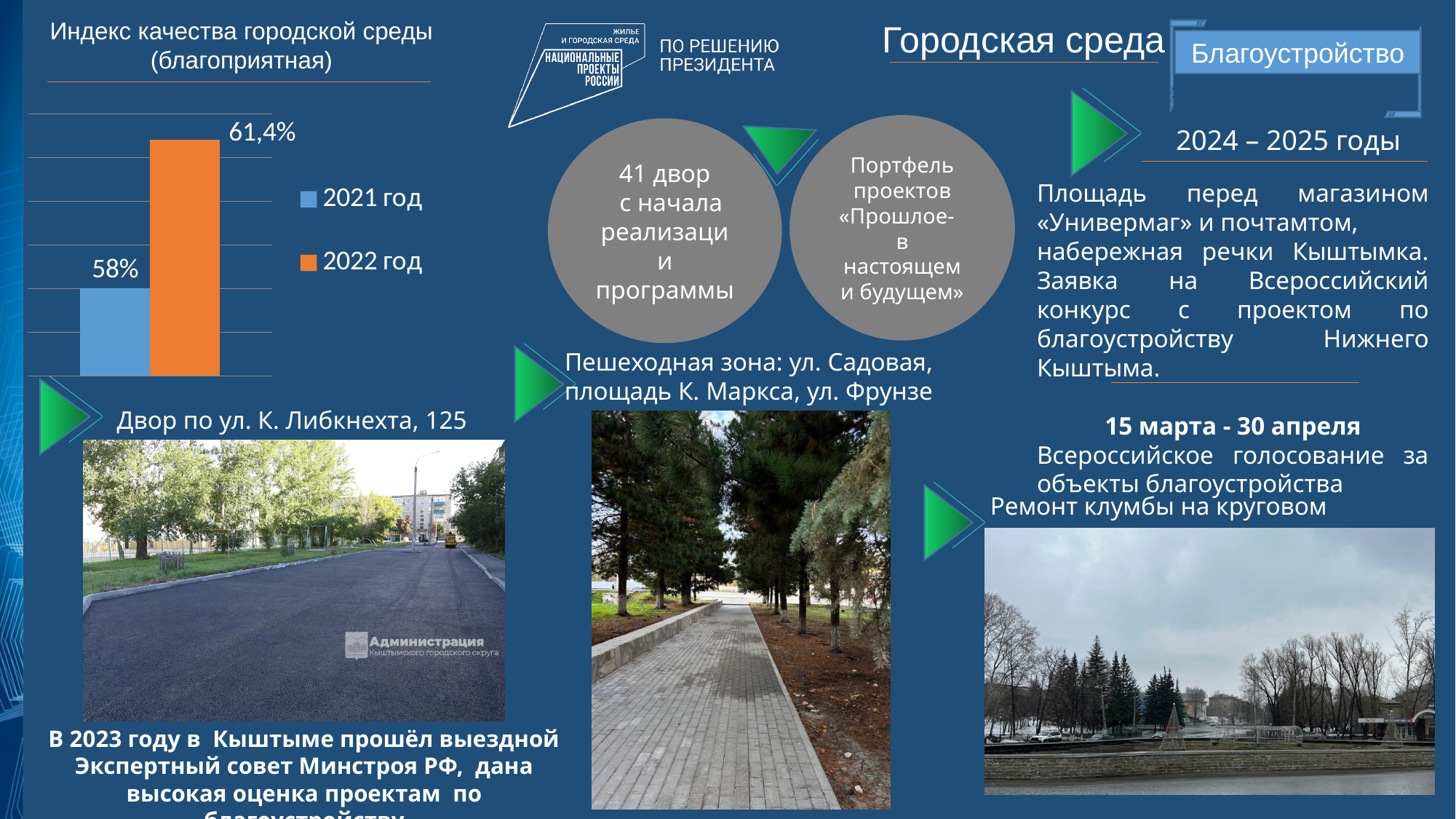
How many bars are plotted in the chart? 2 How many series does the chart legend list? 2 Which year has the highest value in the chart? 2022 год What value does the chart show for 2021 год? 58% Which year has the lowest value in the chart? 2021 год Does the value rise or fall from 2021 год to 2022 год? rise Which year has the higher value in the chart, 2021 год or 2022 год? 2022 год What is the title of the chart? Индекс качества городской среды (благоприятная) What colour is the bar for 2022 год in the chart? orange What value does the chart show for 2022 год? 61,4% By how many percentage points does the 2022 год value exceed the 2021 год value? 3,4 What kind of chart is shown on the slide? bar chart